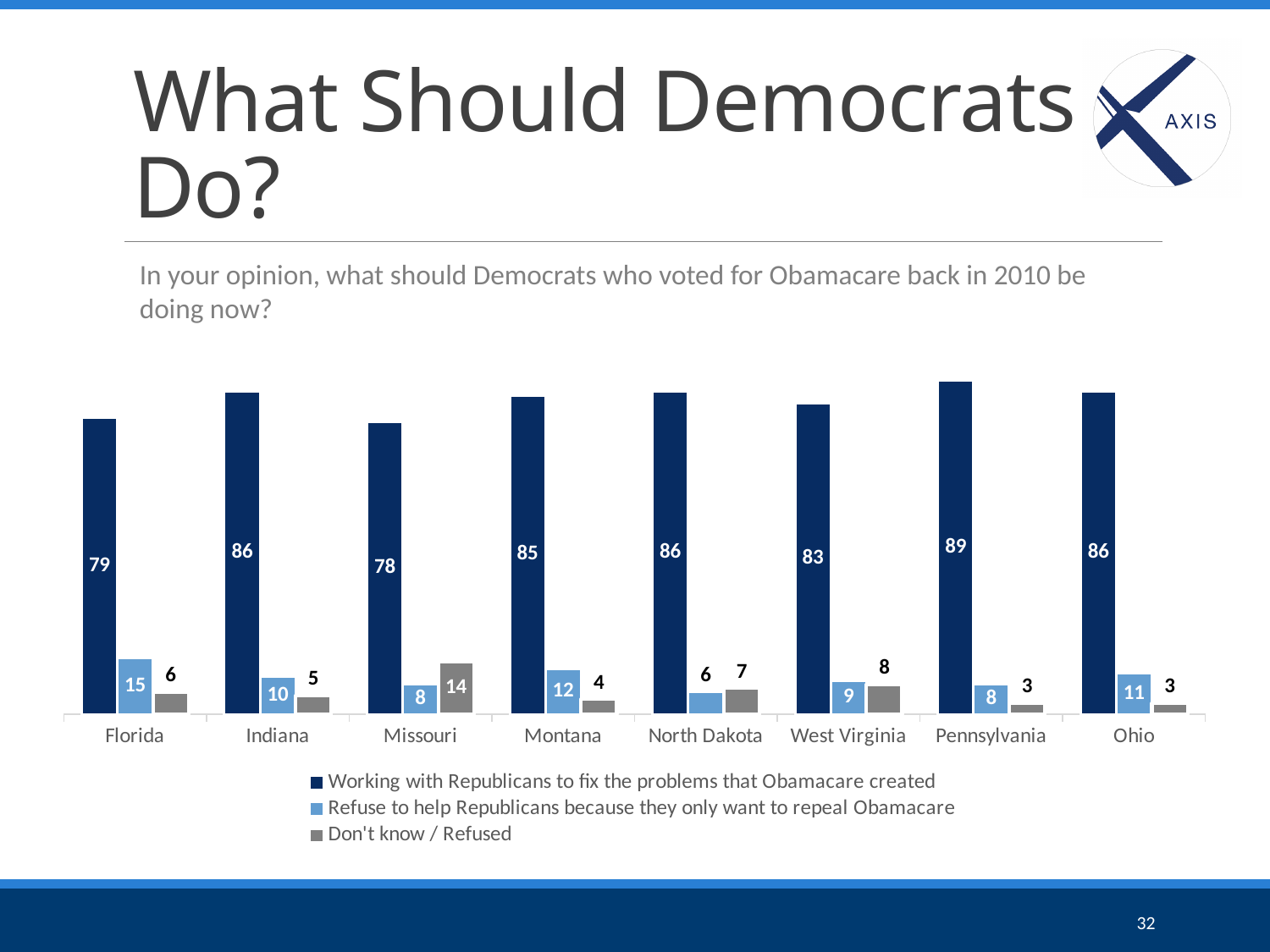
What is the 'Don't know / Refused' value for Missouri? 14 How many series does the legend list? 3 What is the value for 'Working with Republicans to fix the problems that Obamacare created' in Pennsylvania? 89 What is the difference between the 'Working with Republicans' values for Pennsylvania and Missouri? 11 Which state has the highest 'Refuse to help Republicans because they only want to repeal Obamacare' value? Florida How many states are shown on the x axis? 8 What is the difference between the 'Don't know / Refused' values for Missouri and Ohio? 11 Which is larger: the 'Refuse to help Republicans' value for Montana or for Ohio? Montana What is the value for 'Refuse to help Republicans because they only want to repeal Obamacare' in Florida? 15 What kind of chart is shown on the slide? Bar chart Which state has the highest value for 'Working with Republicans to fix the problems that Obamacare created'? Pennsylvania Which state has the lowest value for 'Working with Republicans to fix the problems that Obamacare created'? Missouri